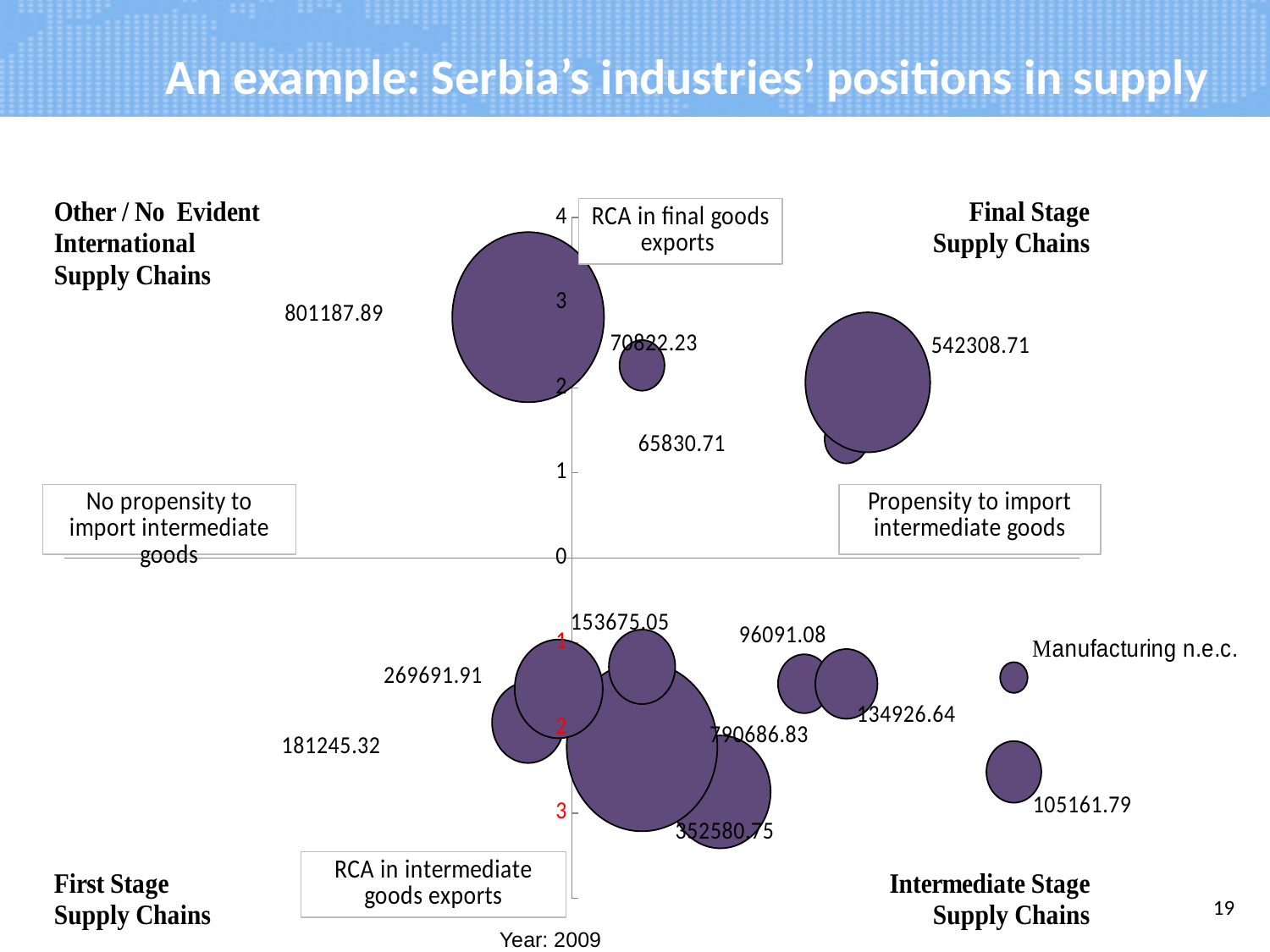
What is the difference between the bubble values 801187.89 and 790686.83? 10501.06 Which printed bubble value is the largest? 801187.89 What is the label shown at the top of the vertical axis? RCA in final goods exports Which is larger, the bubble value 542308.71 or 352580.75? 542308.71 Is the vertical-axis position of the bubble labelled 105161.79 above or below 0? below Which printed bubble value is the smallest? 65830.71 Which is larger, the bubble value 96091.08 or 105161.79? 105161.79 Which bubble is labelled with an industry name instead of a number? Manufacturing n.e.c. What kind of chart is shown on the slide? bubble chart What year does the chart state the data is for? 2009 What is the difference between the bubble values 153675.05 and 134926.64? 18748.41 Is the vertical-axis position of the bubble labelled 542308.71 greater or less than 1? greater